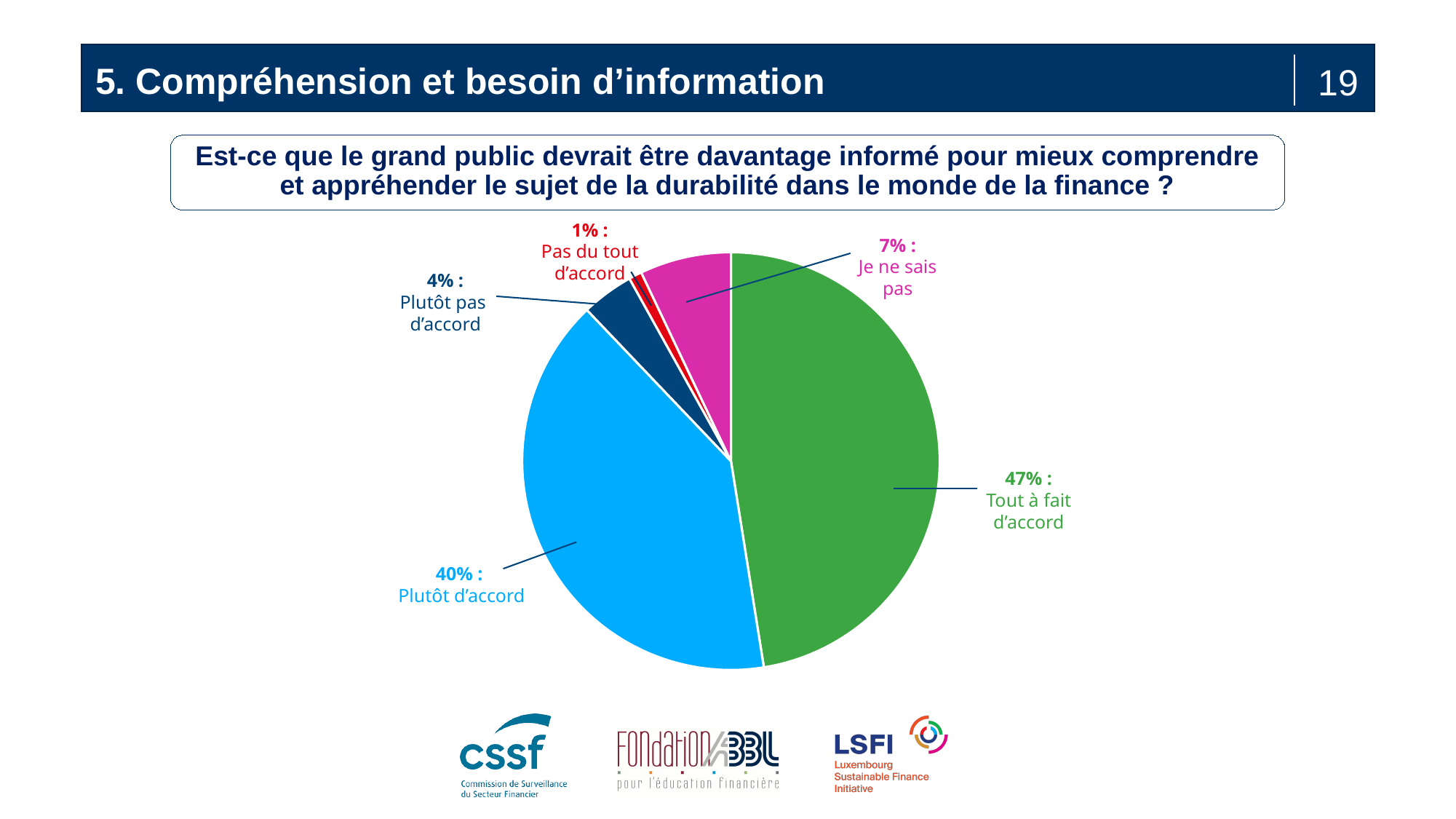
Which response has the largest slice of the pie? Tout à fait d'accord What share of respondents answered "Plutôt d'accord"? 40% What kind of chart is shown on the slide? Pie chart Which is larger: the share for "Je ne sais pas" or the share for "Plutôt pas d'accord"? Je ne sais pas What share of respondents answered "Tout à fait d'accord"? 47% What colour is the slice for "Plutôt d'accord"? Light blue What share of respondents answered "Je ne sais pas"? 7% How many slices does the pie chart have? 5 What share of respondents answered "Plutôt pas d'accord"? 4% What is the difference in percentage points between "Tout à fait d'accord" and "Plutôt d'accord"? 7 percentage points What share of respondents answered "Pas du tout d'accord"? 1% Which response has the smallest slice of the pie? Pas du tout d'accord